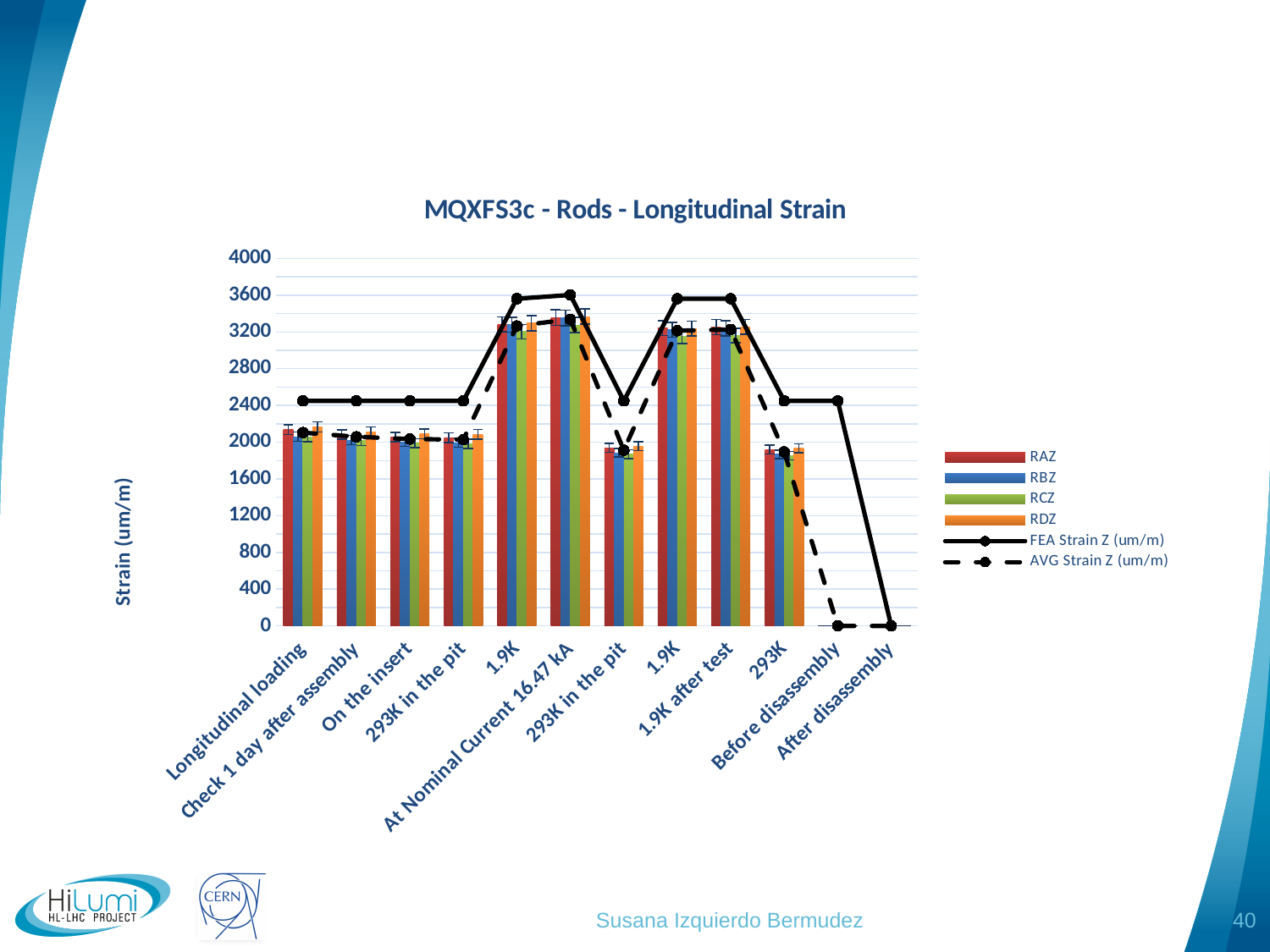
Which is larger for the RBZ series: the value at '1.9K' or the value at '293K'? 1.9K Is the FEA Strain Z (um/m) value at '1.9K' greater or less than 3200? greater What is the value of AVG Strain Z (um/m) at 'After disassembly'? 0 Is the RAZ value at 'At Nominal Current 16.47 kA' greater or less than 2800? greater Is the FEA Strain Z (um/m) value at 'On the insert' greater or less than 2000? greater How many series does the chart legend list? 6 What kind of chart is shown on the slide? combination bar and line chart What is the value of FEA Strain Z (um/m) at 'After disassembly'? 0 How many categories are shown along the x axis of the chart? 12 What is the label of the vertical axis of the chart? Strain (um/m) What is the title of the chart? MQXFS3c - Rods - Longitudinal Strain